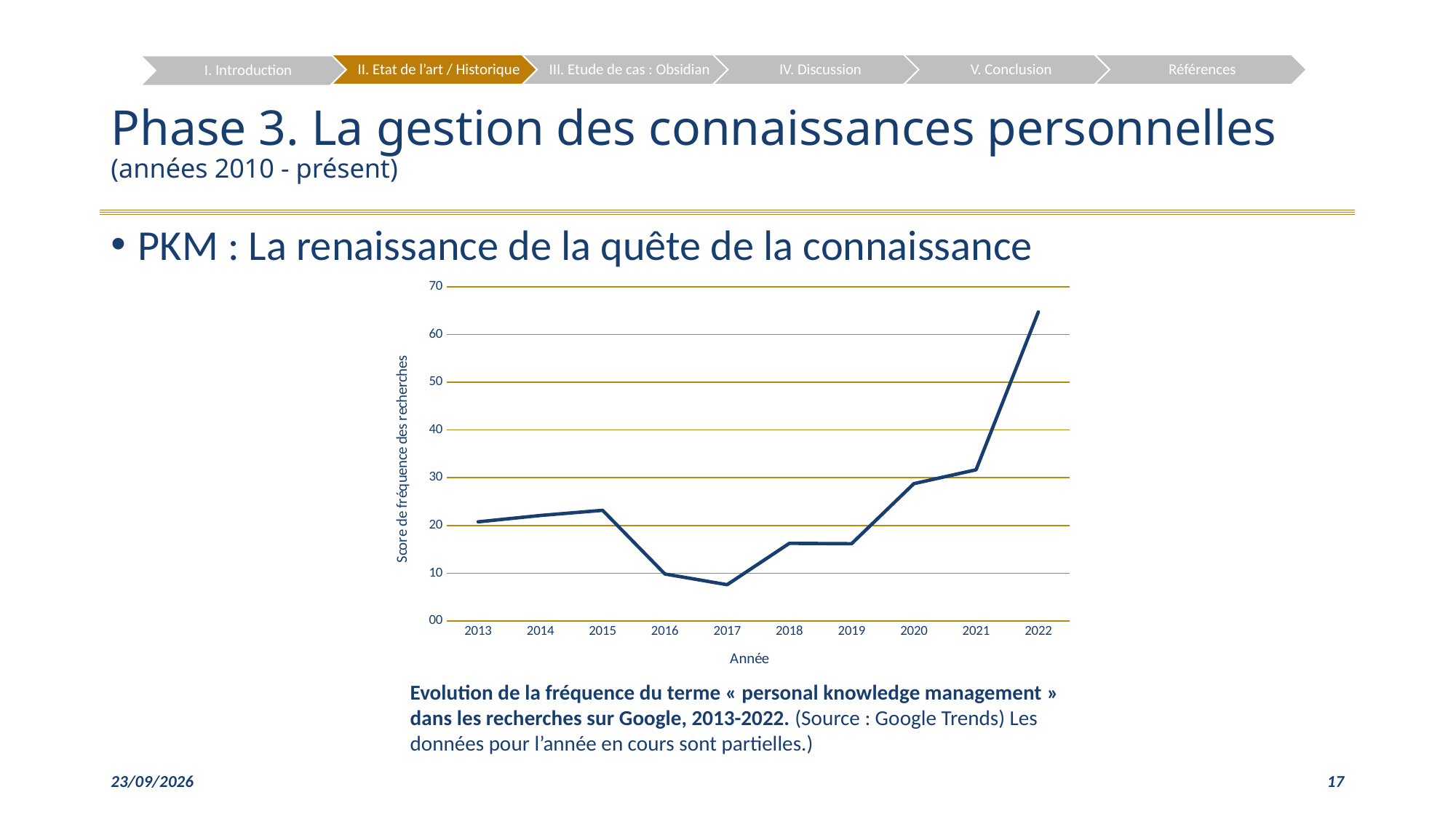
Is the value for 2017 greater or less than 10? less Which year has a higher value, 2013 or 2022? 2022 Which year has a higher value, 2015 or 2016? 2015 Is the value for 2016 greater or less than 20? less Is the value for 2015 greater or less than 20? greater What kind of chart is shown on the slide? line chart Which year has the highest search frequency score in the chart? 2022 Do the values rise or fall from 2017 to 2022? rise What is the label of the x axis of the chart? Année Which year has the lowest search frequency score in the chart? 2017 How many years are plotted on the x axis of the chart? 10